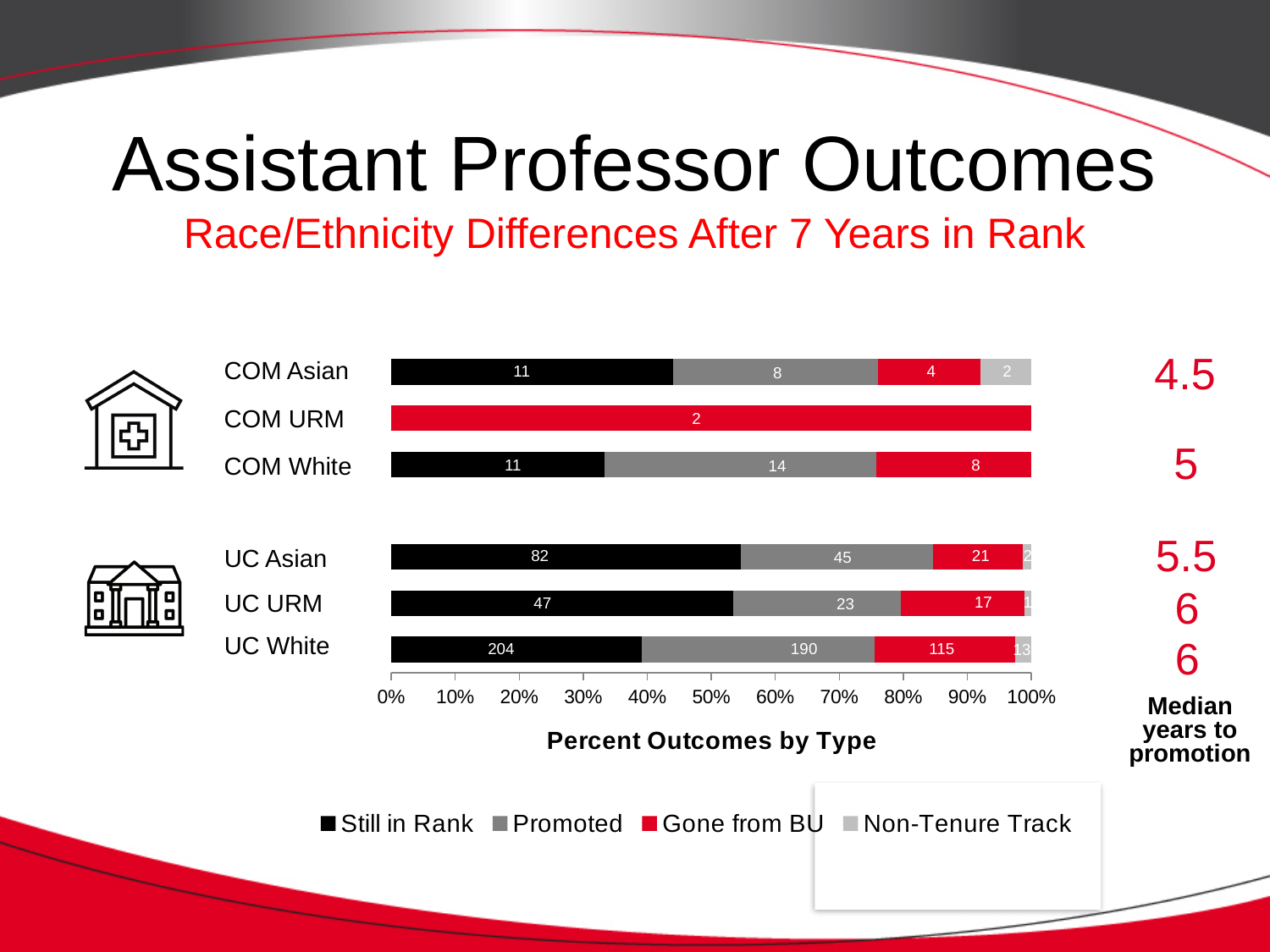
How many data labels are shown for the Still in Rank series for UC White? 1 How many categories are plotted on the chart? 6 Which is larger, the Gone from BU value for UC URM or for COM White? UC URM Which category has the highest Still in Rank value? UC White What is the Promoted value for COM White? 14 What is the total of all labelled values in the UC URM bar? 88 What type of chart is shown on the slide? Bar chart What is the Non-Tenure Track value for UC White? 13 What is the total of all labelled values in the COM Asian bar? 25 What is the difference between the Promoted values for UC White and UC Asian? 14 What is the Gone from BU value for UC Asian? 21 How many series does the legend list? 4